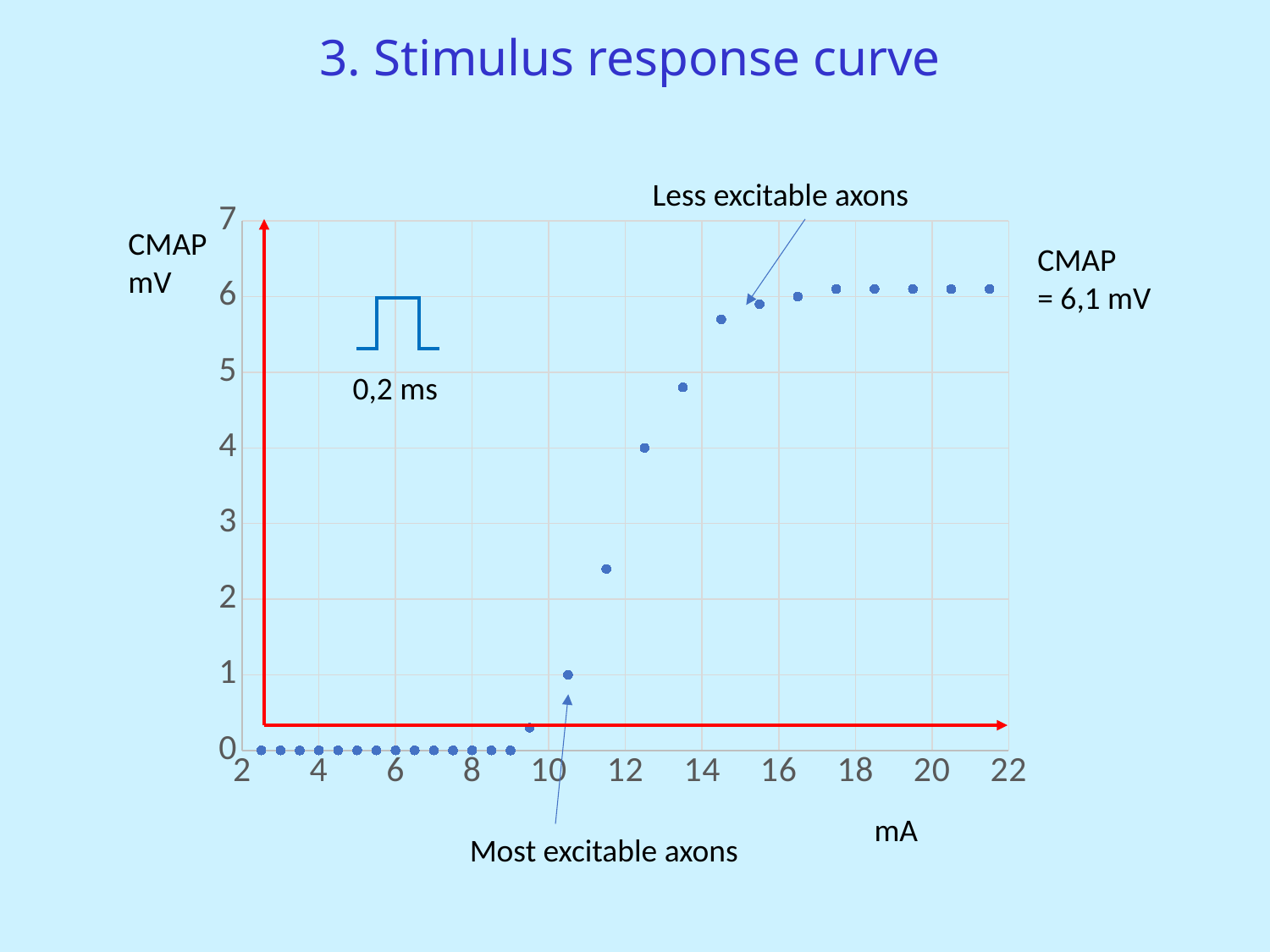
Which has the larger CMAP value: the point at 8 mA or the point at 18 mA? 18 mA Is the CMAP value at 10 mA greater or less than 2? less What CMAP value does the curve plateau at, according to the annotation on the right? 6,1 mV What stimulus duration is shown next to the pulse symbol on the chart? 0,2 ms Is the CMAP value at 6 mA greater or less than 1? less Do the CMAP values rise or fall as the stimulus current (mA) increases along the x axis? rise What is the unit shown on the x axis? mA What kind of chart is shown on the slide? scatter chart Is the CMAP value at 14 mA greater or less than 3? greater